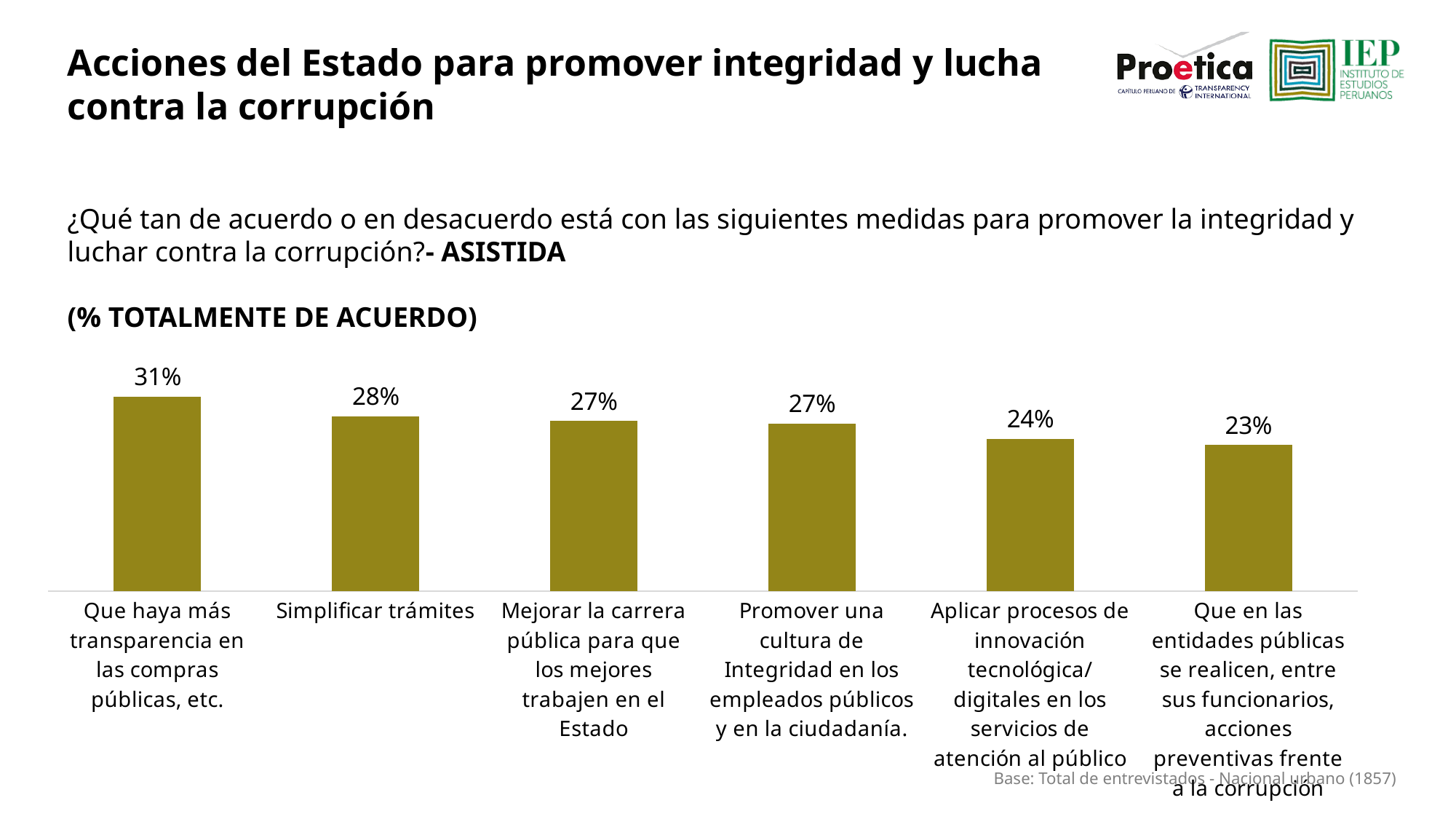
Which measure has the lowest percentage? Que en las entidades públicas se realicen, entre sus funcionarios, acciones preventivas frente a la corrupción What is the difference between the highest and lowest values in the chart? 8% What type of chart is shown on the slide? Bar chart How many measures (bars) are shown in the chart? 6 What percentage is shown for "Simplificar trámites"? 28% What percentage is shown for "Aplicar procesos de innovación tecnológica/digitales en los servicios de atención al público"? 24% What is the value for "Que haya más transparencia en las compras públicas, etc."? 31% Which is larger: the value for "Simplificar trámites" or the value for "Promover una cultura de Integridad en los empleados públicos y en la ciudadanía."? Simplificar trámites What is the base (number of respondents) stated at the bottom of the slide? Total de entrevistados - Nacional urbano (1857) Which measure has the highest percentage of "totalmente de acuerdo"? Que haya más transparencia en las compras públicas, etc. What is the difference between the value for "Que haya más transparencia en las compras públicas, etc." and the value for "Simplificar trámites"? 3% Do the values rise or fall from left to right across the chart? Fall